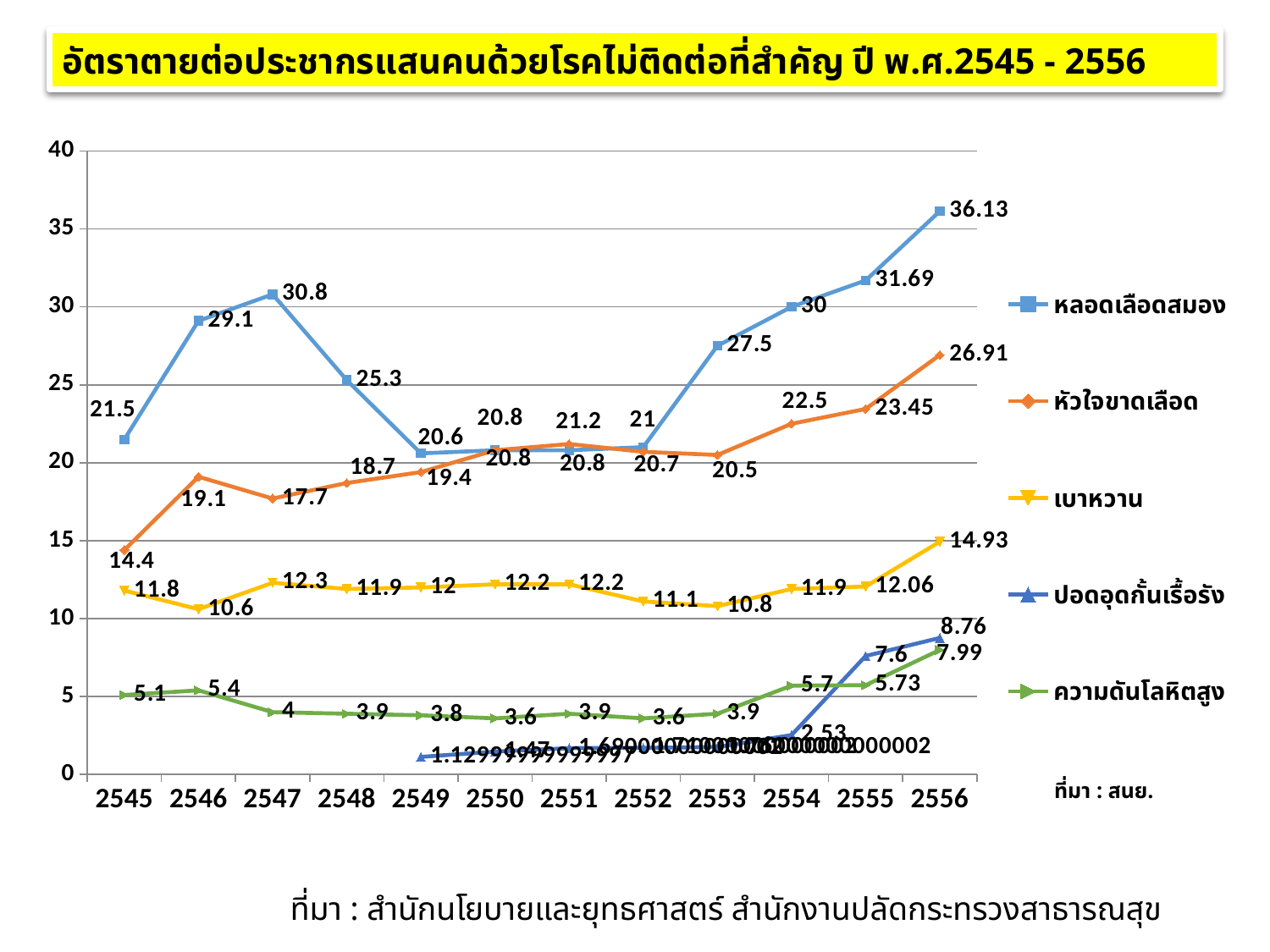
What is the value for เบาหวาน in 2553? 10.8 What is the value for หัวใจขาดเลือด in 2545? 14.4 How many series does the legend list? 5 Which series is shown in green in the legend? ความดันโลหิตสูง Which series has the larger value in 2556, ปอดอุดกั้นเรื้อรัง or ความดันโลหิตสูง? ปอดอุดกั้นเรื้อรัง What kind of chart is shown on the slide? line chart What is the difference between the หลอดเลือดสมอง value in 2556 and in 2555? 4.44 Does the value for หัวใจขาดเลือด rise or fall from 2553 to 2556? rise In which year is the value for ความดันโลหิตสูง lowest? 2550 and 2552 (3.6) What is the value for หลอดเลือดสมอง in 2556? 36.13 How many years are shown along the x axis? 12 In which year is the value for หลอดเลือดสมอง highest? 2556